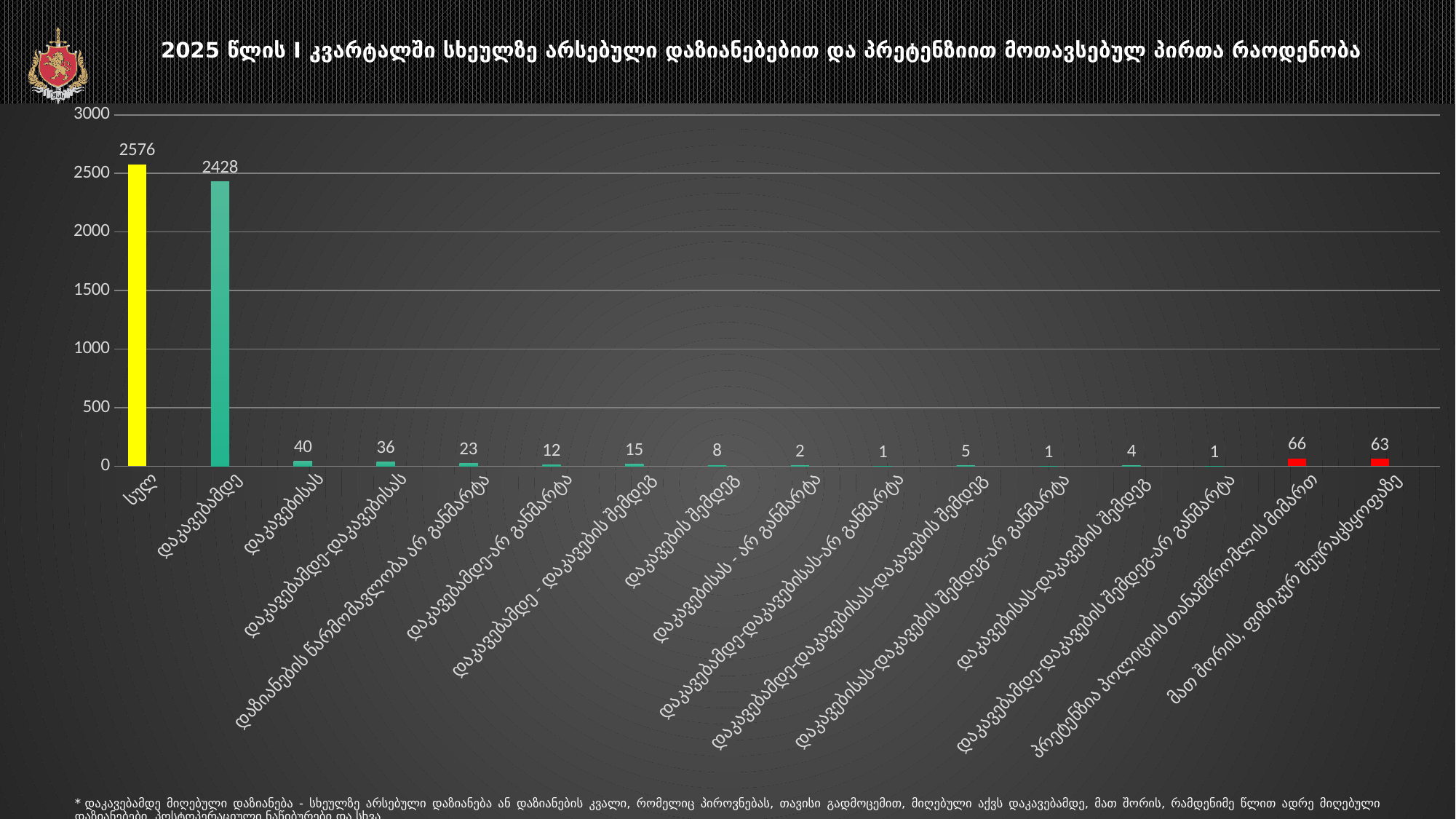
What is the difference between the values for სულ and დაკავებამდე? 148 What is the value for პრეტენზია პოლიციის თანამშრომლის მიმართ? 66 What is the value for დაკავებისას? 40 What is the value for სულ? 2576 What is the value for მათ შორის, ფიზიკურ შეურაცხყოფაზე? 63 How many categories are shown on the x axis? 16 What is the value for დაკავებამდე? 2428 Is the value for დაკავებამდე greater or less than 2000? greater Which is larger, the value for დაკავებისას or the value for დაკავებამდე-დაკავებისას? დაკავებისას Which category has the highest value? სულ What colour is the bar for სულ? yellow What kind of chart is shown on the slide? bar chart